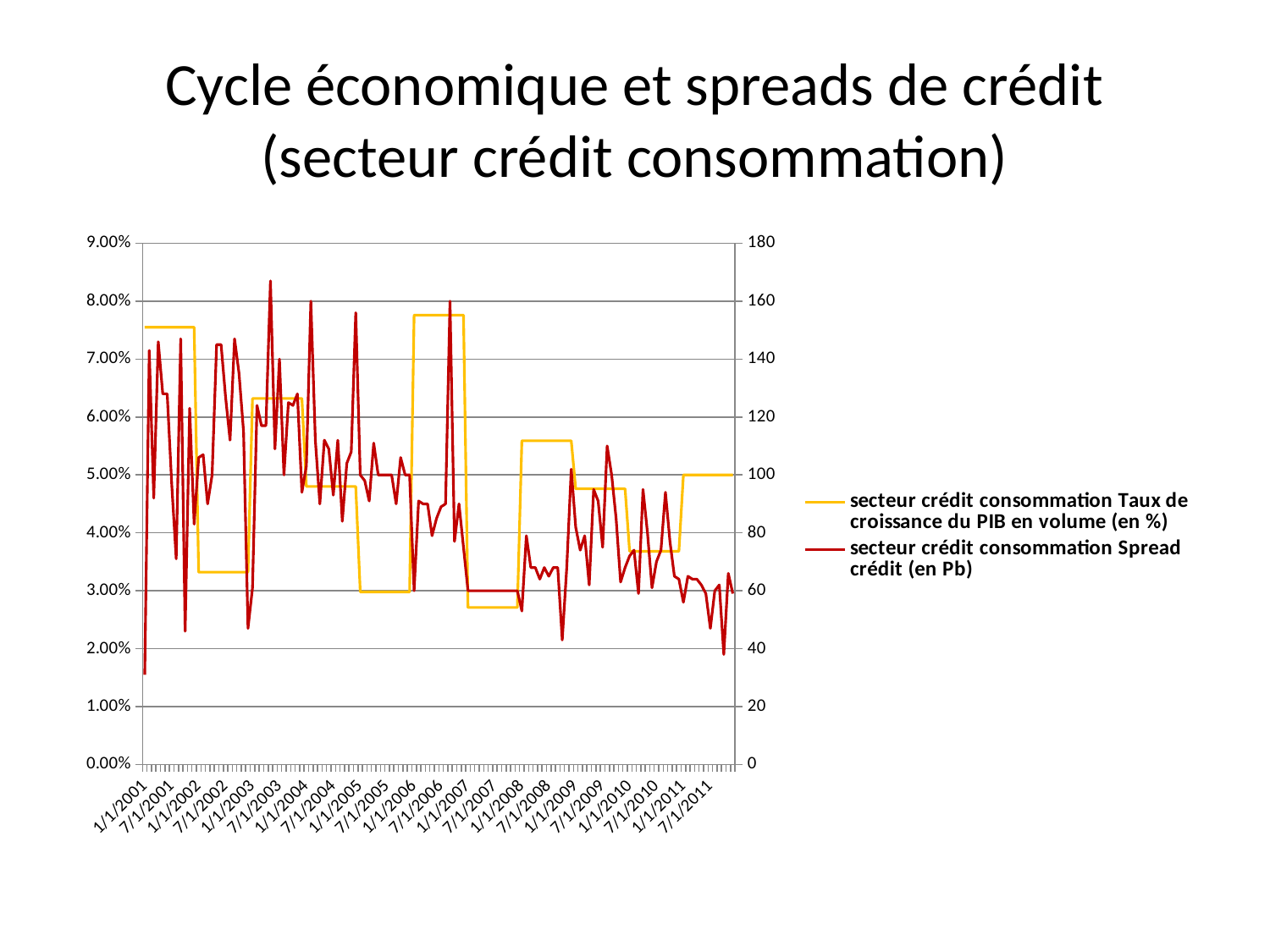
Is the value of the GDP growth series (Taux de croissance du PIB) in the second half of 2007 greater or less than 3.00%? less Which is higher for the GDP growth series: the level during 2006 or the level in the second half of 2007? 2006 Which series is drawn in red? secteur crédit consommation Spread crédit (en Pb) Is the value of the GDP growth series (Taux de croissance du PIB) during 2008 greater or less than 5.00%? greater Is the first value of the credit spread series (Spread crédit) at 1/1/2001 greater or less than 40? less Does the credit spread series (Spread crédit) generally rise or fall from 2004 to 2011? fall What is the title of the chart on the slide? Cycle économique et spreads de crédit (secteur crédit consommation) What kind of chart is shown on the slide? line chart How many date labels are shown on the x axis? 22 How many series does the legend list? 2